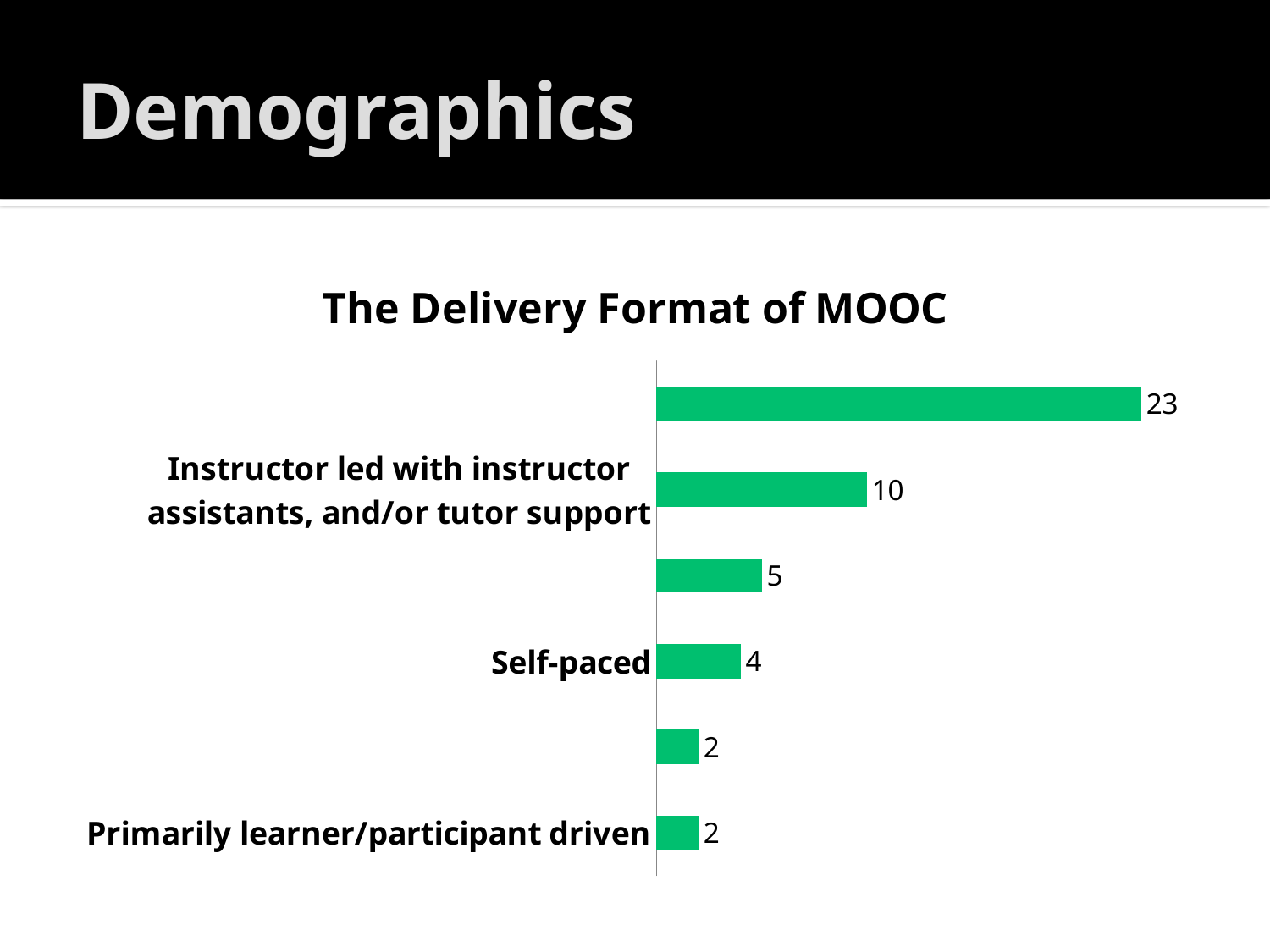
What kind of chart is shown on the slide? Bar chart How many bars are plotted on the chart? 6 What is the value for Instructor led with instructor assistants, and/or tutor support? 10 What is the value for Self-paced? 4 What is the title of the chart? The Delivery Format of MOOC What colour are the bars in the chart? Green What is the difference between the values for Instructor led with instructor assistants, and/or tutor support and Self-paced? 6 What is the value for Primarily learner/participant driven? 2 Which is larger, the value for Self-paced or the value for Primarily learner/participant driven? Self-paced What is the highest value shown on the chart? 23 What is the sum of all the values shown on the chart? 46 What is the lowest value shown on the chart? 2